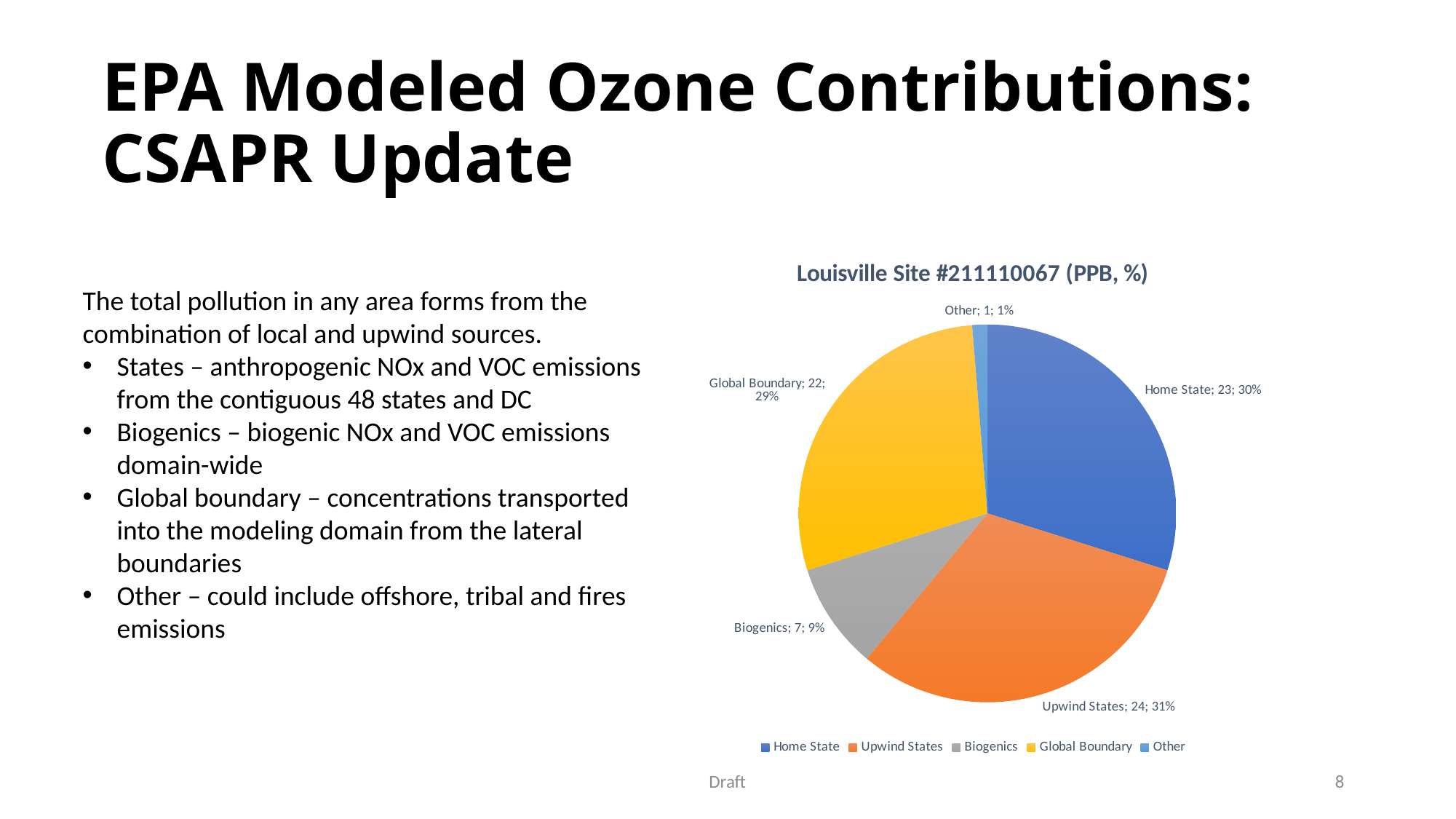
What is the PPB value shown for Biogenics? 7 Which category has the largest slice in the pie chart? Upwind States Which is larger in PPB, Global Boundary or Biogenics? Global Boundary How many categories are shown in the pie chart? 5 What type of chart is shown on the slide? Pie chart What share of the pie does Global Boundary account for? 29% What percentage share does Upwind States have in the pie chart? 31% What is the difference in PPB between Home State and Biogenics? 16 What is the title of the chart? Louisville Site #211110067 (PPB, %) What colour is the Global Boundary slice in the pie chart? Yellow Which category has the smallest slice in the pie chart? Other What is the PPB value for Home State in the Louisville Site #211110067 pie chart? 23